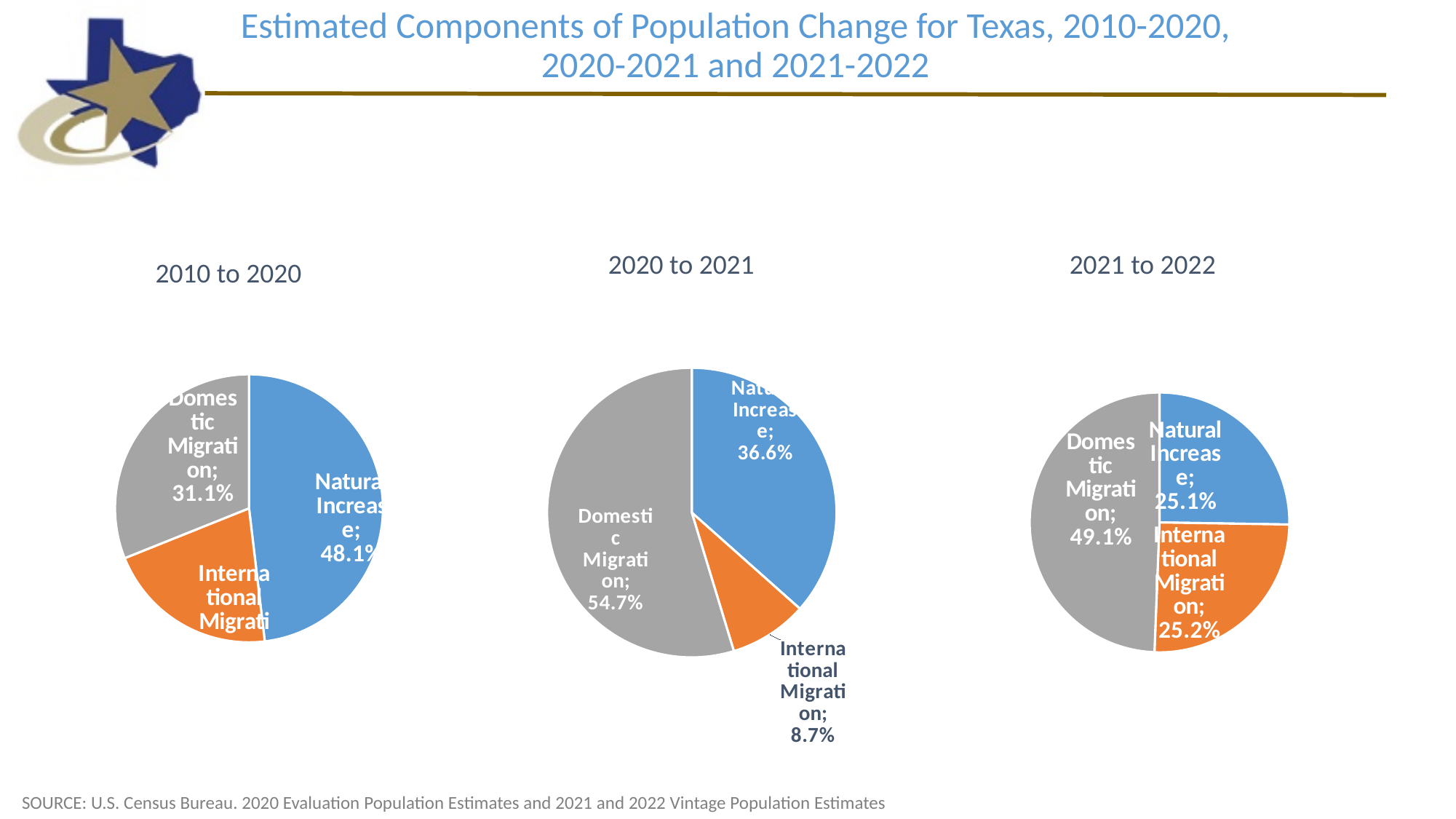
What kind of chart is used for each of the three periods on the slide? Pie chart In the 2020 to 2021 pie chart, what share is International Migration? 8.7% In the 2010 to 2020 pie chart, what share is Natural Increase? 48.1% In the 2010 to 2020 pie chart, which component has the largest share? Natural Increase In the 2020 to 2021 pie chart, which component has the smallest share? International Migration How many pie charts are shown on the slide? 3 In the 2020 to 2021 pie chart, what is the difference between the Domestic Migration share and the Natural Increase share? 18.1 percentage points In the 2021 to 2022 pie chart, what share is Natural Increase? 25.1% In the 2010 to 2020 pie chart, which is larger, Natural Increase or Domestic Migration? Natural Increase In the 2010 to 2020 pie chart, what share is Domestic Migration? 31.1% In the 2020 to 2021 pie chart, what share is Domestic Migration? 54.7% In the 2021 to 2022 pie chart, which component has the largest share? Domestic Migration